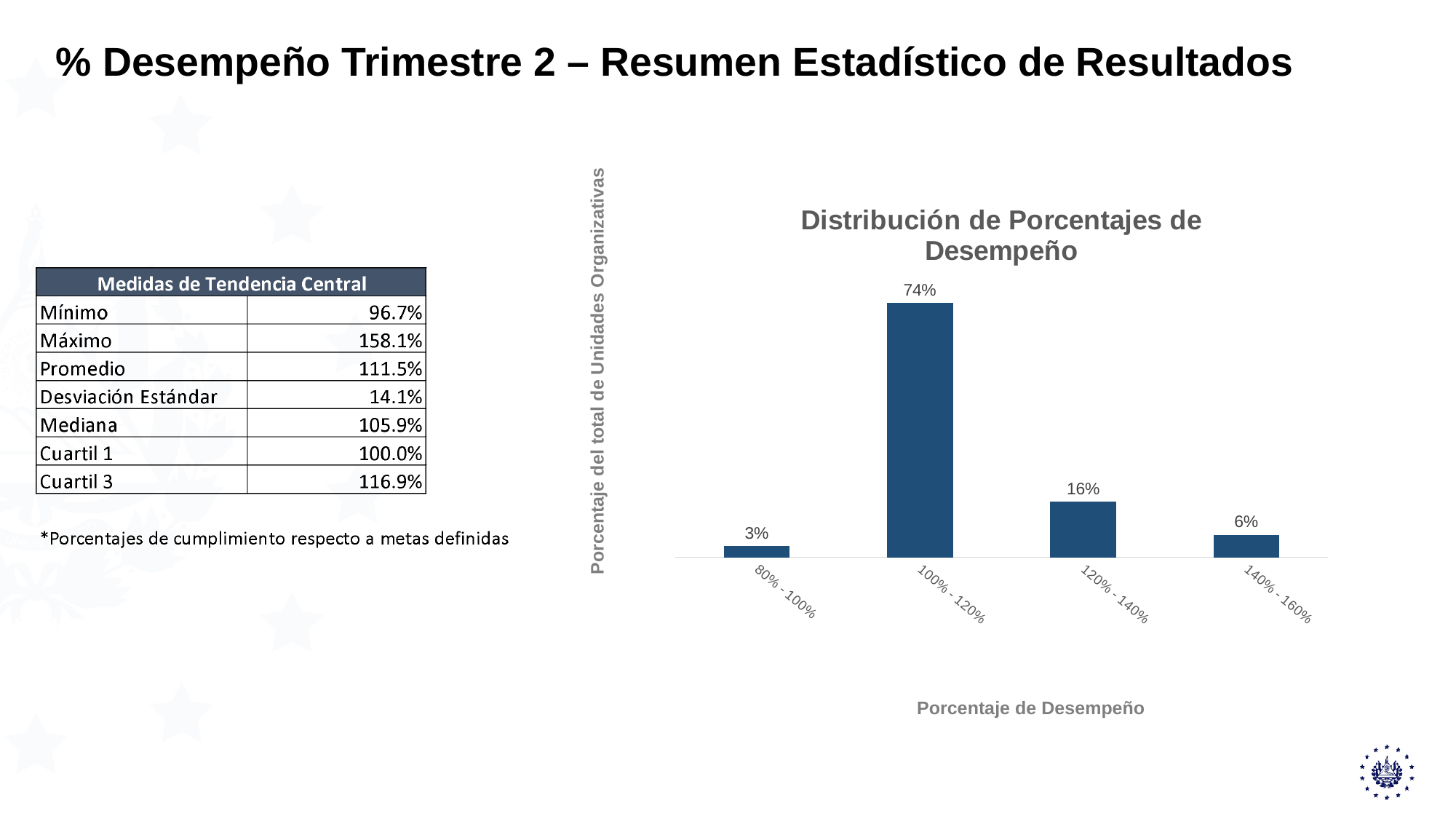
What kind of chart is shown? Bar chart What is the difference between the values for 120% - 140% and 140% - 160%? 10% What is the difference between the values for 100% - 120% and 120% - 140%? 58% What is the value for the 140% - 160% category? 6% Which is larger, the value for 140% - 160% or the value for 80% - 100%? 140% - 160% What is the value for the 120% - 140% category? 16% What is the value for the 100% - 120% category? 74% What is the value for the 80% - 100% category? 3% What is the title of the chart? Distribución de Porcentajes de Desempeño Which category has the lowest value? 80% - 100% How many categories are shown on the x axis? 4 Which category has the highest value? 100% - 120%